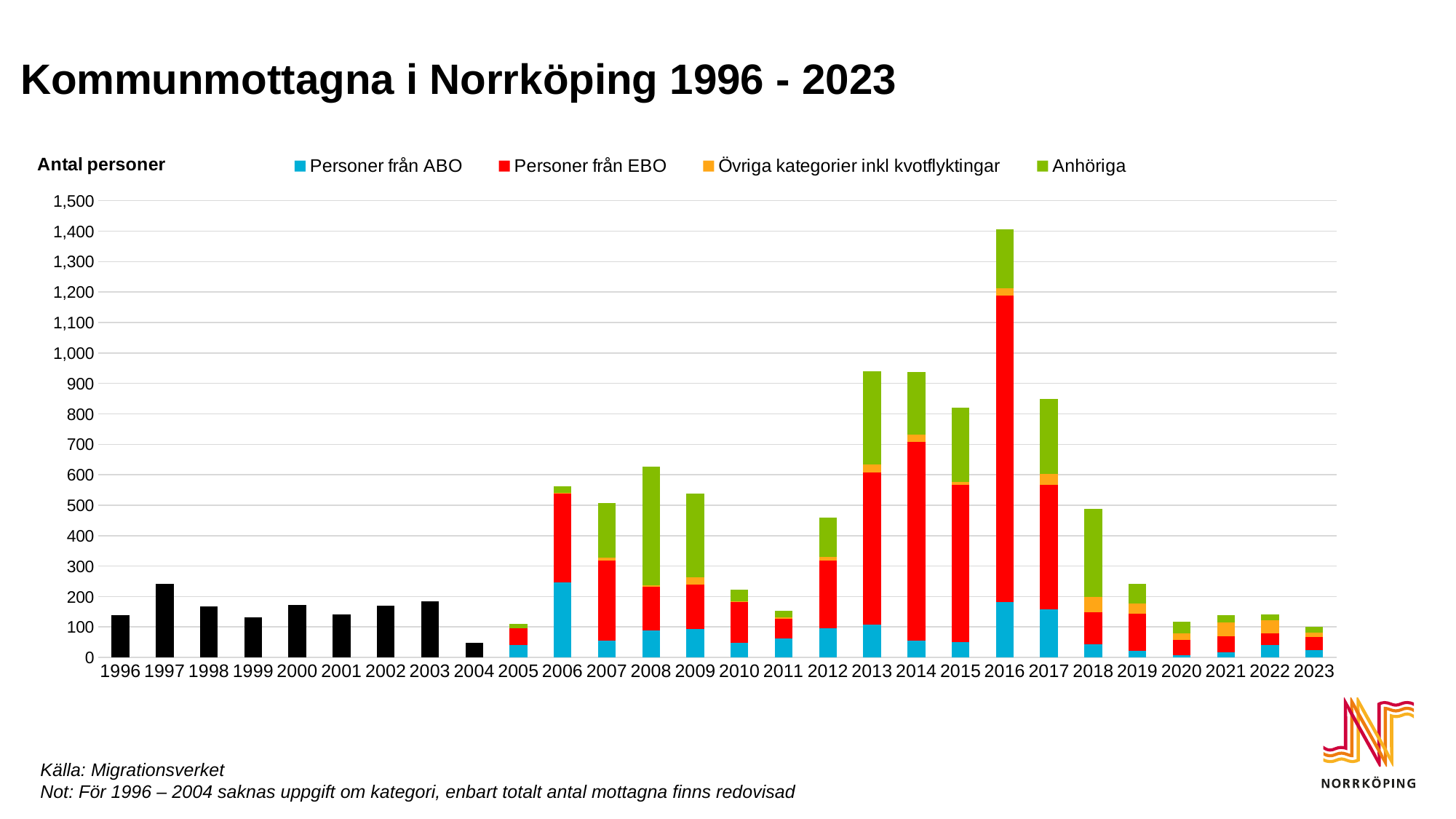
How many years are shown along the x axis? 28 How many series does the legend list? 4 What kind of chart is shown on the slide? Stacked bar chart Is the total for 2004 greater or less than 100? less Which colour represents the series 'Anhöriga' in the legend? Green Is the total for 2016 greater or less than 1,300? greater Which year has the lowest total number of persons? 2004 Is the total for 1997 greater or less than 200? greater Which year has a higher total, 2008 or 2007? 2008 Do the totals rise or fall from 2016 to 2020? fall Which year has the highest total number of persons? 2016